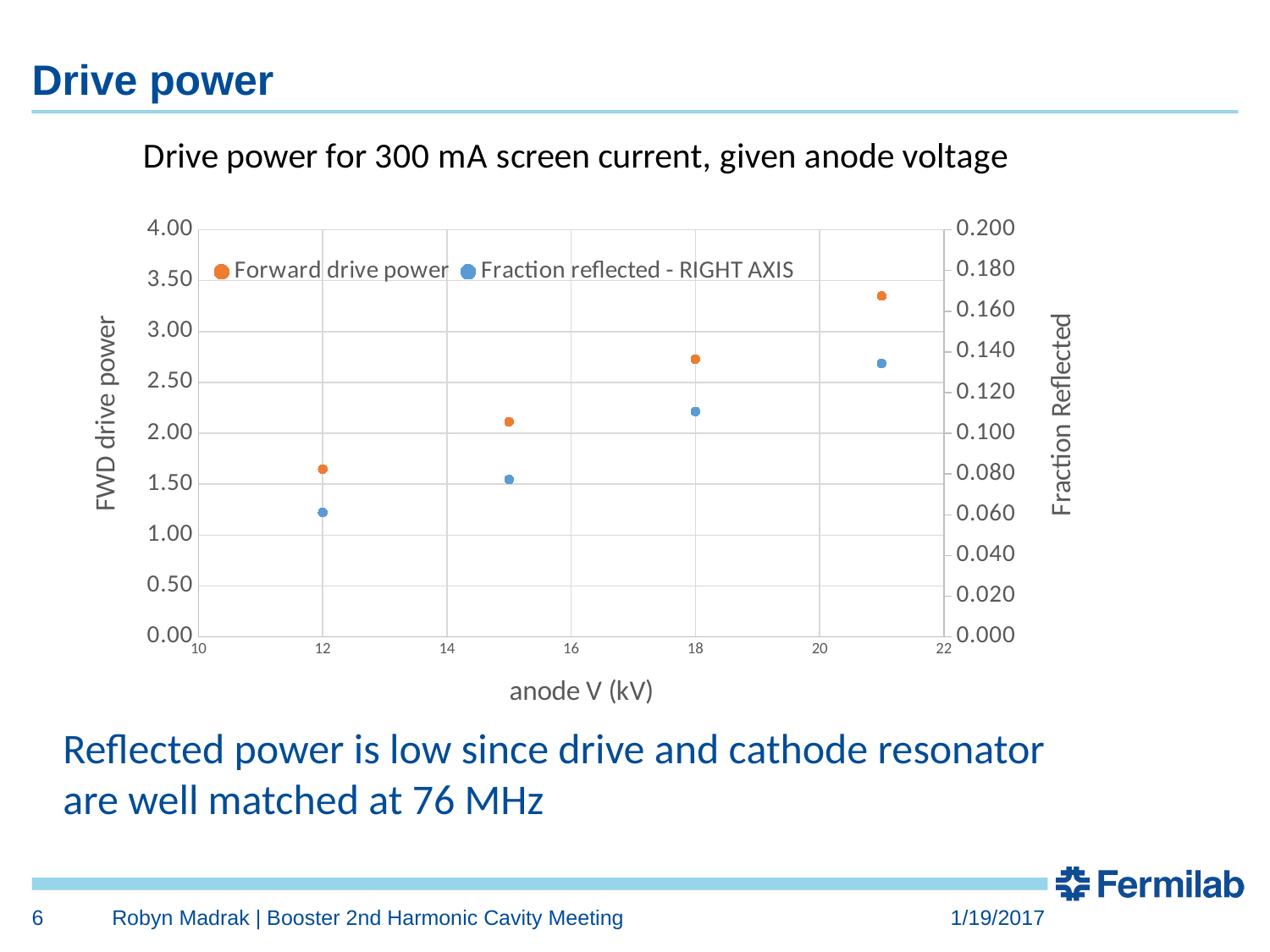
At which anode voltage is the Fraction reflected lowest? 12 kV Is the Forward drive power at 21 kV greater or less than 3.00? greater Does the Forward drive power rise or fall as anode voltage increases? rise What kind of chart is shown on the slide? scatter chart Is the Fraction reflected at 15 kV greater or less than 0.100? less Is the Forward drive power at 12 kV greater or less than 2.00? less What is the label of the right-hand vertical axis? Fraction Reflected How many data points are plotted for the Forward drive power series? 4 At which anode voltage is the Forward drive power highest? 21 kV How many series does the chart legend list? 2 Which is larger, the Forward drive power at 18 kV or at 15 kV? 18 kV